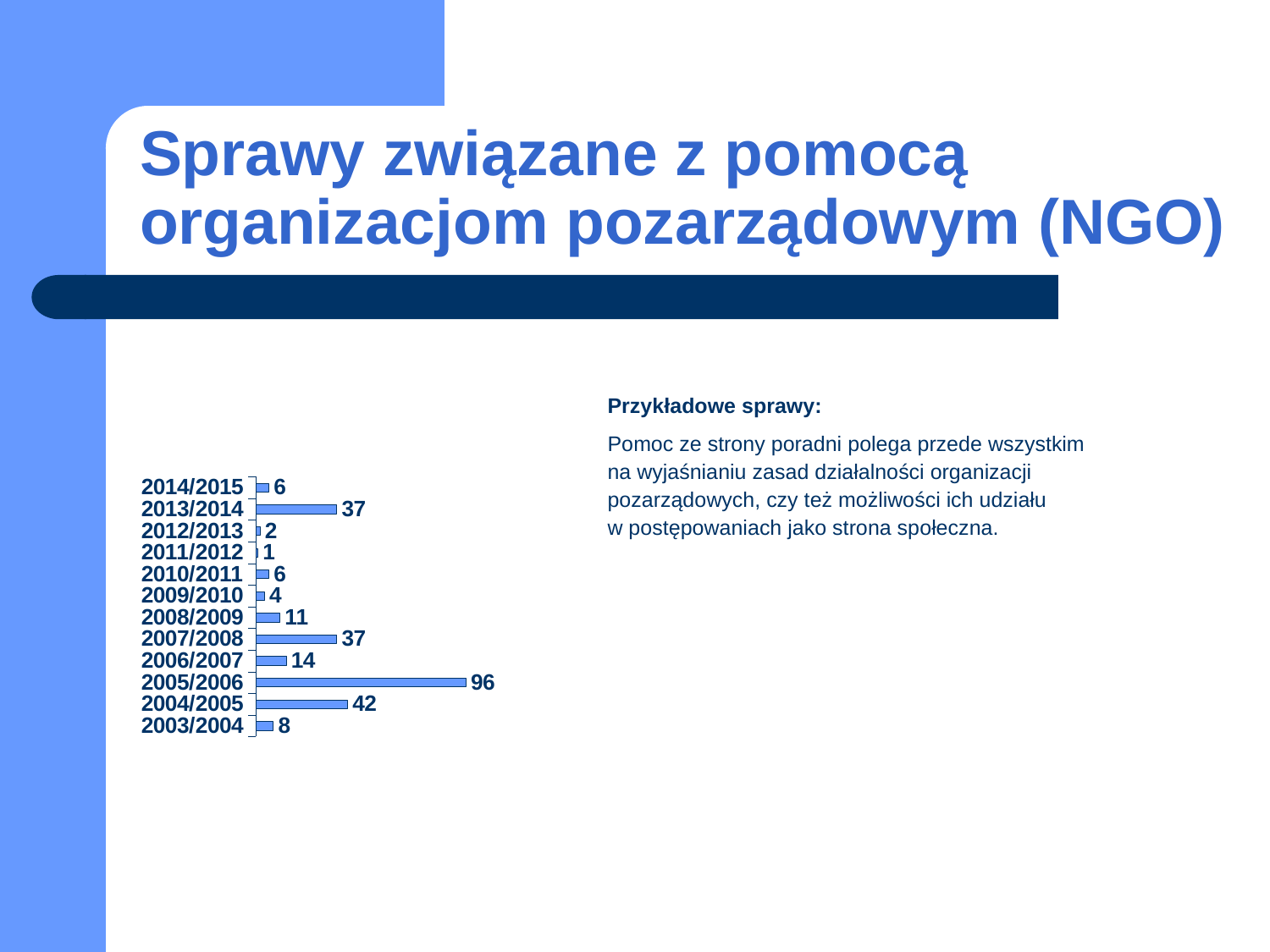
Which category has the lowest value? 2011/2012 What is the value for 2010/2011? 6 Which category has the highest value? 2005/2006 What kind of chart is shown on the slide? bar chart What is the difference between the values for 2005/2006 and 2004/2005? 54 What is the value for 2003/2004? 8 What is the value for 2005/2006? 96 Which is larger, the value for 2014/2015 or the value for 2012/2013? 2014/2015 What is the value for 2013/2014? 37 Which is larger, the value for 2006/2007 or the value for 2008/2009? 2006/2007 How many categories are shown in the chart? 12 What is the difference between the values for 2007/2008 and 2009/2010? 33